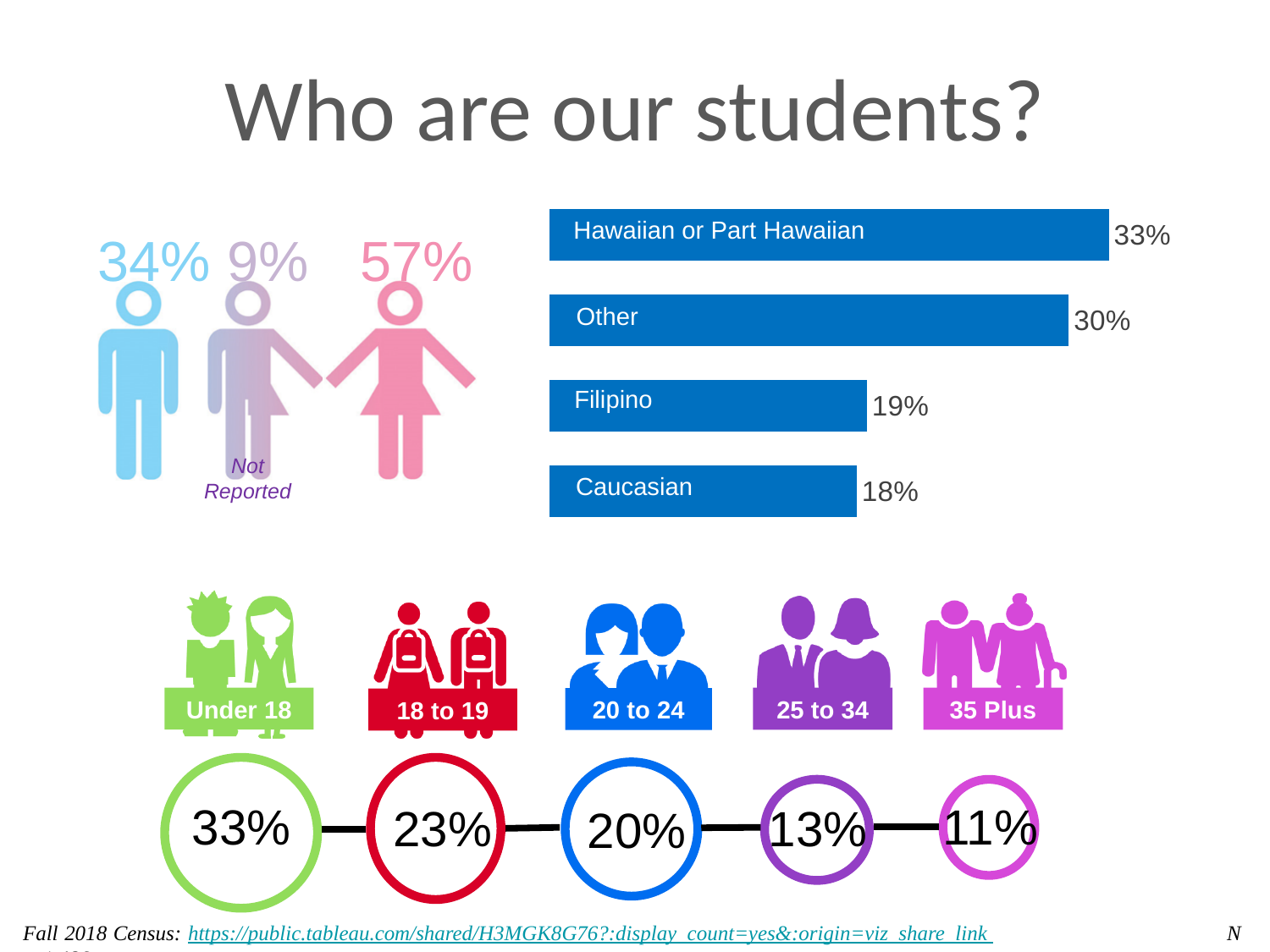
In the age graphic at the bottom of the slide, what is the difference between the Under 18 and 18 to 19 percentages? 10% In the bar chart on the right, which is larger, the value for Other or the value for Filipino? Other In the age graphic at the bottom of the slide, which age group has the lowest percentage? 35 Plus In the bar chart on the right, which category has the lowest value? Caucasian In the bar chart on the right, which category has the highest value? Hawaiian or Part Hawaiian How many categories does the bar chart on the right show? 4 In the bar chart on the right, what is the value for Filipino? 19% In the bar chart on the right, what is the value for Caucasian? 18% In the bar chart on the right, what is the difference between the values for Hawaiian or Part Hawaiian and Other? 3% In the age graphic at the bottom of the slide, what is the percentage for the 20 to 24 group? 20% In the bar chart on the right, what is the value for Hawaiian or Part Hawaiian? 33% What kind of chart is shown on the right side of the slide? Bar chart